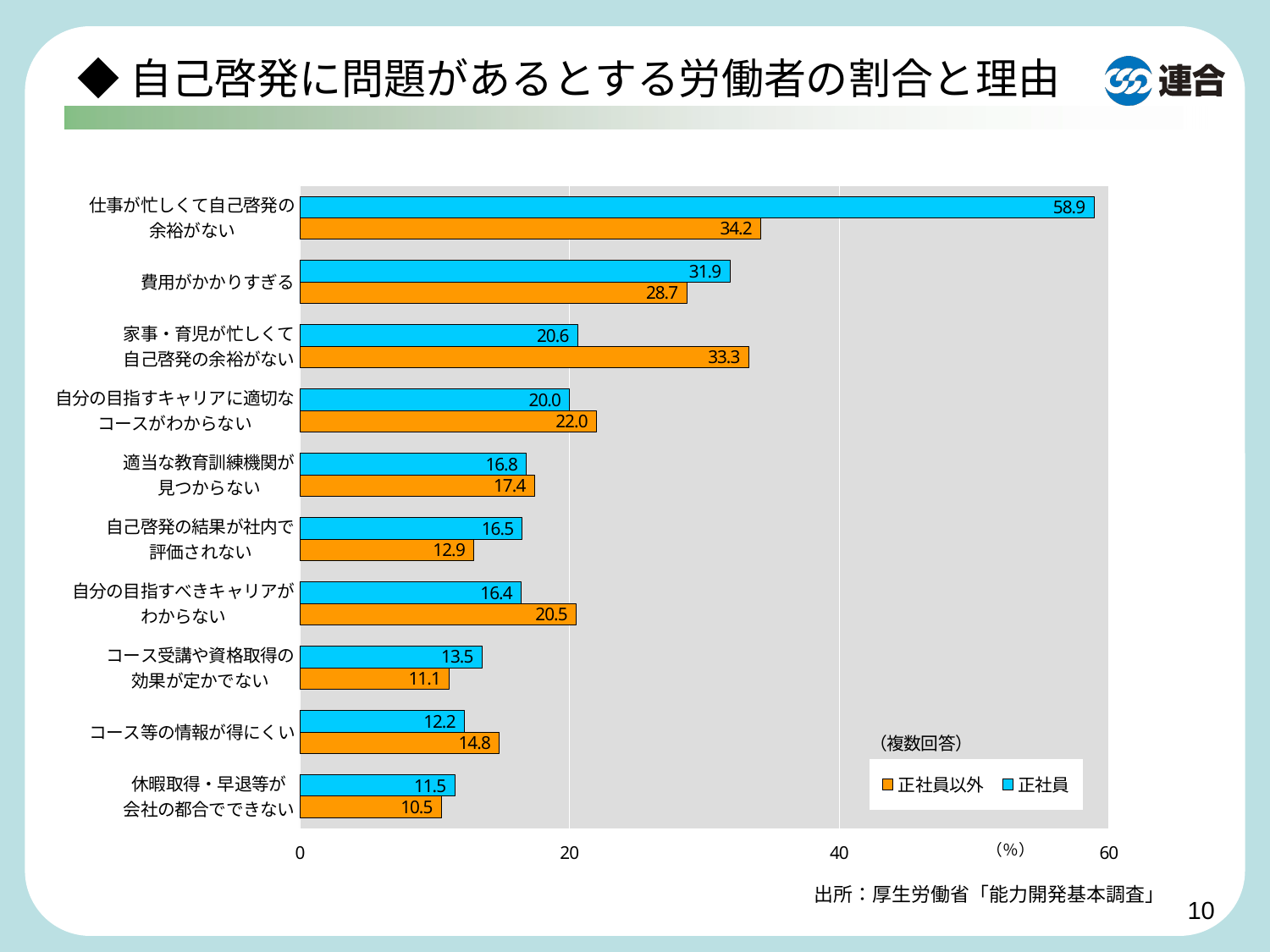
For 自分の目指すべきキャリアがわからない, which series has the larger value, 正社員 or 正社員以外? 正社員以外 Which colour represents 正社員以外 in the chart? orange What is the difference between the 正社員 and 正社員以外 values for 仕事が忙しくて自己啓発の余裕がない? 24.7 What is the value for 正社員以外 in the category 費用がかかりすぎる? 28.7 Which category has the lowest value for 正社員以外? 休暇取得・早退等が会社の都合でできない Which category has the highest value for 正社員? 仕事が忙しくて自己啓発の余裕がない What kind of chart is shown on the slide? bar chart Is the 正社員 value for 費用がかかりすぎる greater or less than 40? less What is the value for 正社員 in the category 仕事が忙しくて自己啓発の余裕がない? 58.9 How many series does the legend list? 2 How many categories are shown in the chart? 10 What is the value for 正社員以外 in the category 家事・育児が忙しくて自己啓発の余裕がない? 33.3